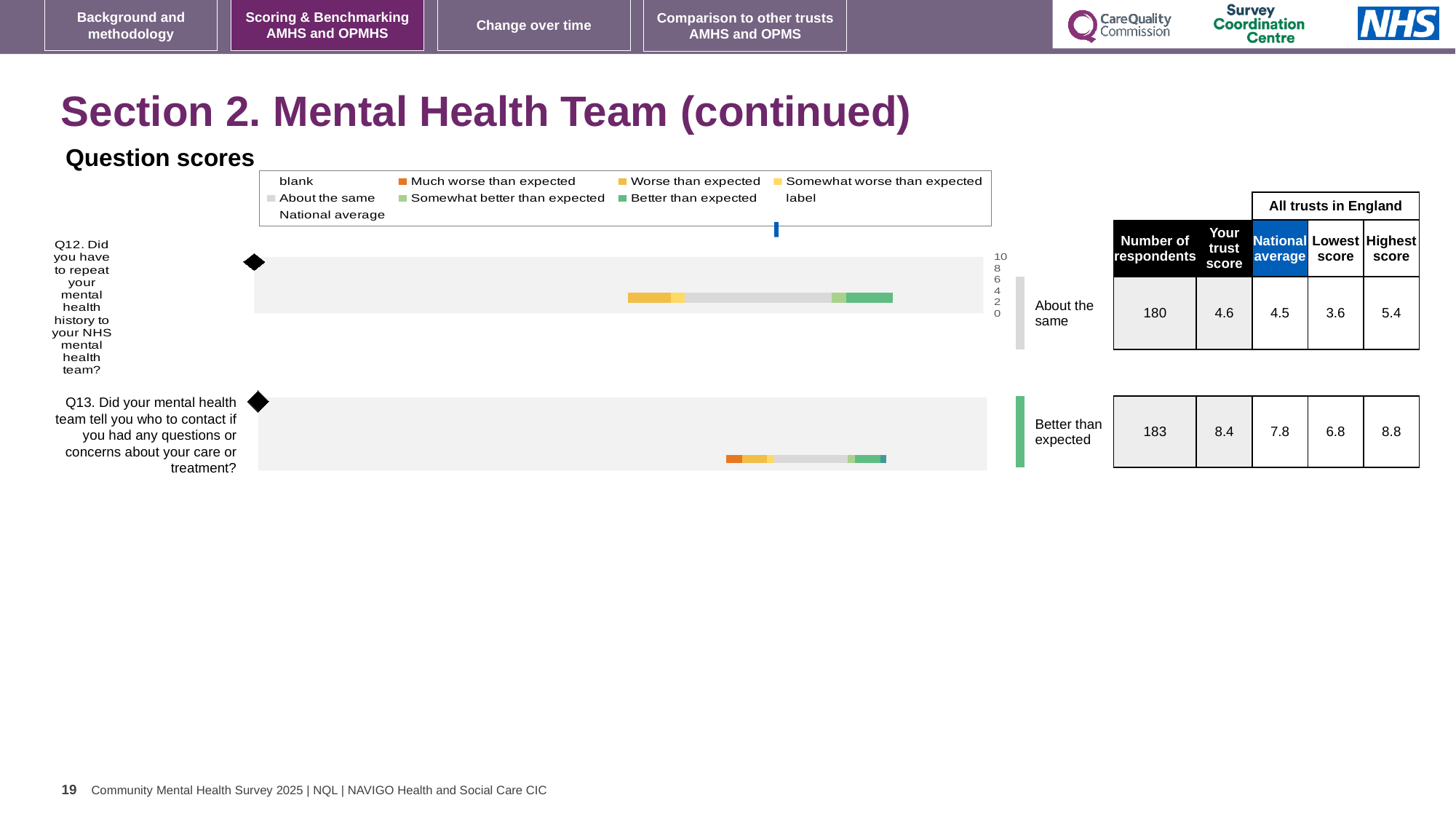
What is the lowest score among all trusts in England shown for Q12? 3.6 What is the highest score among all trusts in England shown for Q13? 8.8 How many respondents are shown for Q13? 183 What benchmark category is shown next to the Q13 chart? Better than expected What is the national average score shown for Q12? 4.5 What is the 'Your trust score' value for Q12 (Did you have to repeat your mental health history to your NHS mental health team?)? 4.6 For Q13, which is larger: the trust score or the national average? Your trust score How many questions are charted on this slide? 2 For Q12, what is the difference between the highest score and the lowest score among all trusts in England? 1.8 What benchmark category is shown next to the Q12 chart? About the same For Q13, what is the difference between the trust score and the national average? 0.6 What is the 'Your trust score' value for Q13 (Did your mental health team tell you who to contact if you had any questions or concerns about your care or treatment?)? 8.4